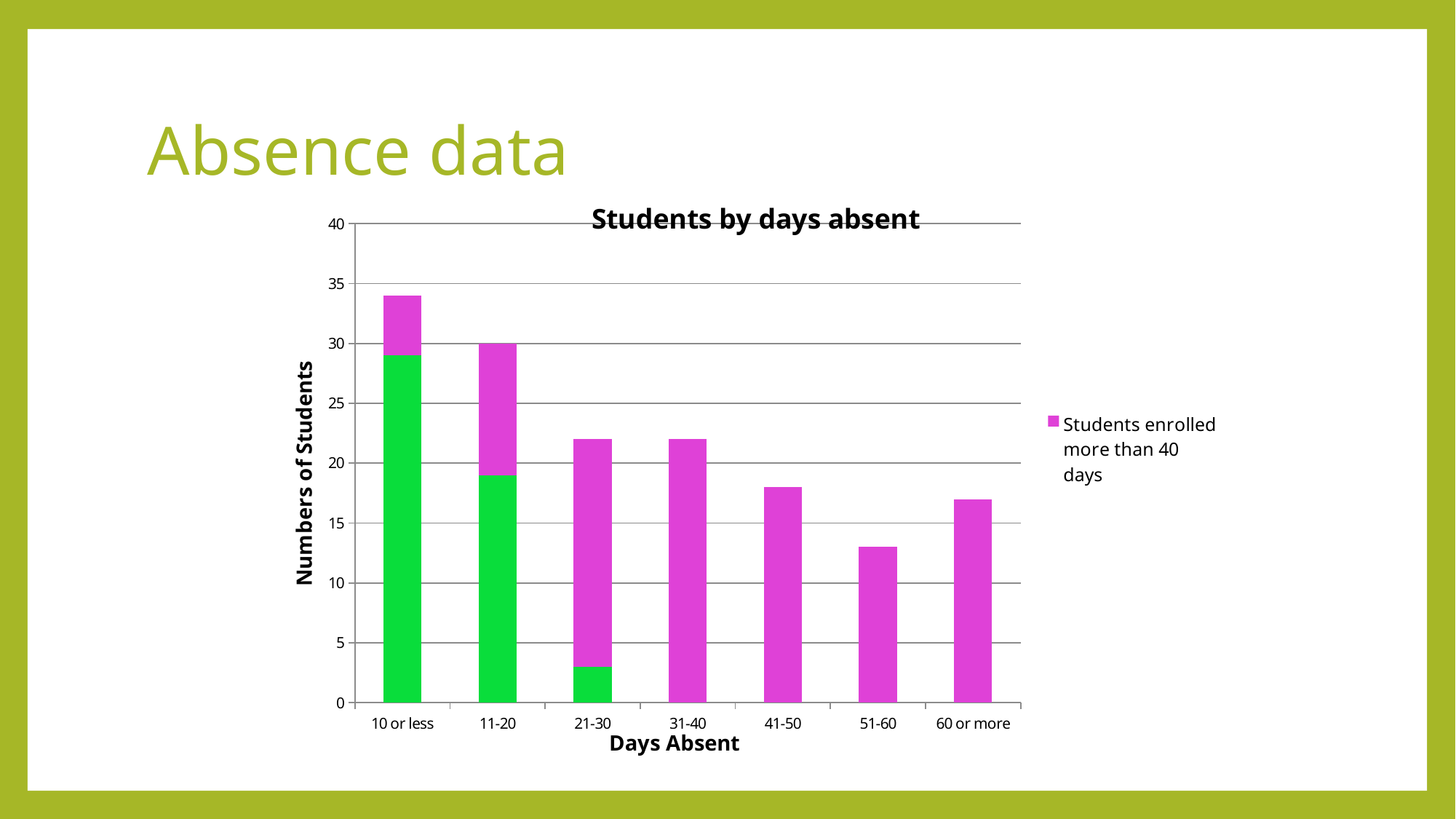
What is the total height of the bar for the 11-20 category? 30 Which bar is taller, 10 or less or 11-20? 10 or less Do the bar heights generally rise or fall as days absent increase along the x axis? Fall What is the title of the chart? Students by days absent How many categories are shown on the x axis of the chart? 7 Is the value for the 51-60 category greater or less than 15? less Which days-absent category has the tallest bar? 10 or less Is the value for the 31-40 category greater or less than 20? greater What type of chart is shown on the slide? Stacked bar chart Is the total bar height for the 10 or less category greater or less than 30? greater How many series does the chart's legend list? 1 Which days-absent category has the shortest bar? 51-60